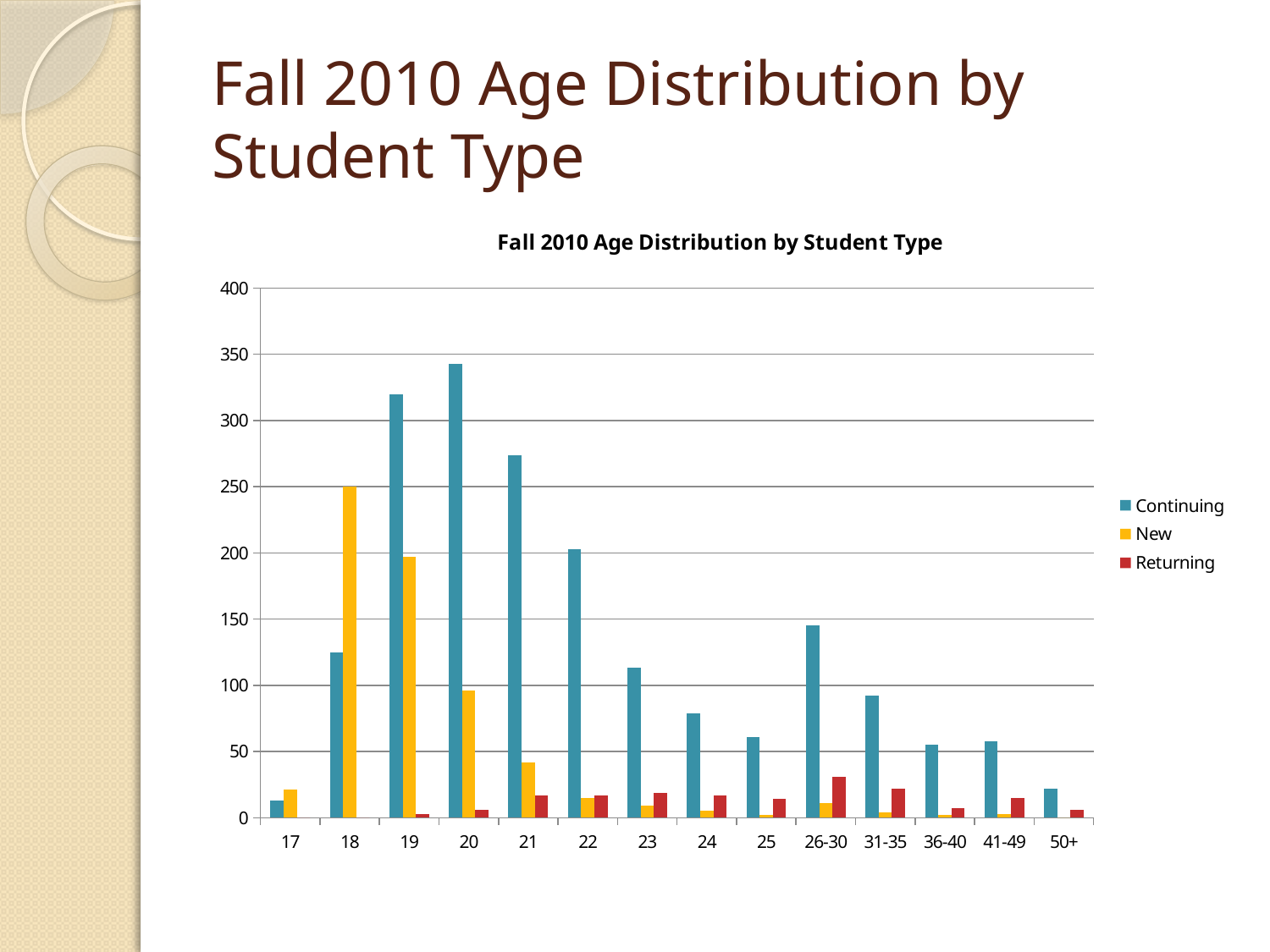
Which age category has the highest Continuing value? 20 How many age categories are shown on the x axis? 14 How many series does the legend list? 3 What kind of chart is shown on the slide? bar chart Which age category has the highest New value? 18 Do the Continuing values rise or fall from age 20 to age 25? fall Which is larger, the Continuing value for age 19 or for age 20? 20 Which is larger, the Continuing value for 26-30 or for 31-35? 26-30 Is the Continuing value for age 20 greater or less than 300? greater Is the Continuing value for the 50+ category greater or less than 50? less Which age category has the highest Returning value? 26-30 Is the Continuing value for age 21 greater or less than 250? greater